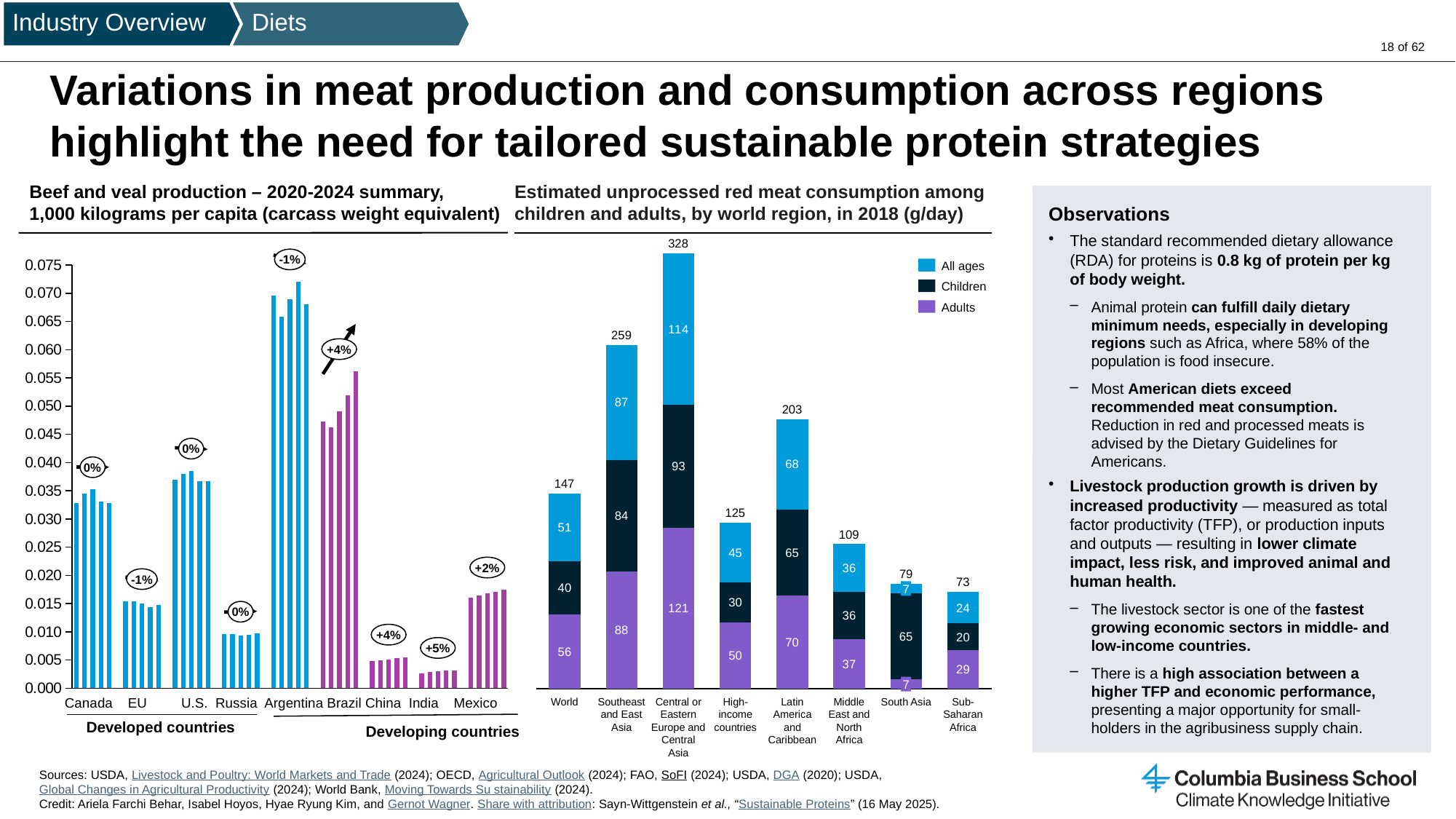
What kind of chart is the beef and veal production chart on the left? Bar chart In the red meat consumption chart, what is the total value shown for Central or Eastern Europe and Central Asia? 328 In the beef and veal production chart, what percentage change is annotated for India? +5% In the red meat consumption chart, what is the Children value for South Asia? 65 In the beef and veal production chart, are the values for Argentina greater or less than 0.060? greater In the red meat consumption chart, what is the Adults value for Southeast and East Asia? 88 In the red meat consumption chart, which region has the lowest total? Sub-Saharan Africa In the red meat consumption chart, which is larger: the All ages value for Latin America and Caribbean or for Middle East and North Africa? Latin America and Caribbean How many regions are shown in the red meat consumption chart? 8 In the red meat consumption chart, what is the difference between the totals for World and High-income countries? 22 How many series does the legend of the red meat consumption chart list? 3 In the red meat consumption chart, which region has the highest total? Central or Eastern Europe and Central Asia